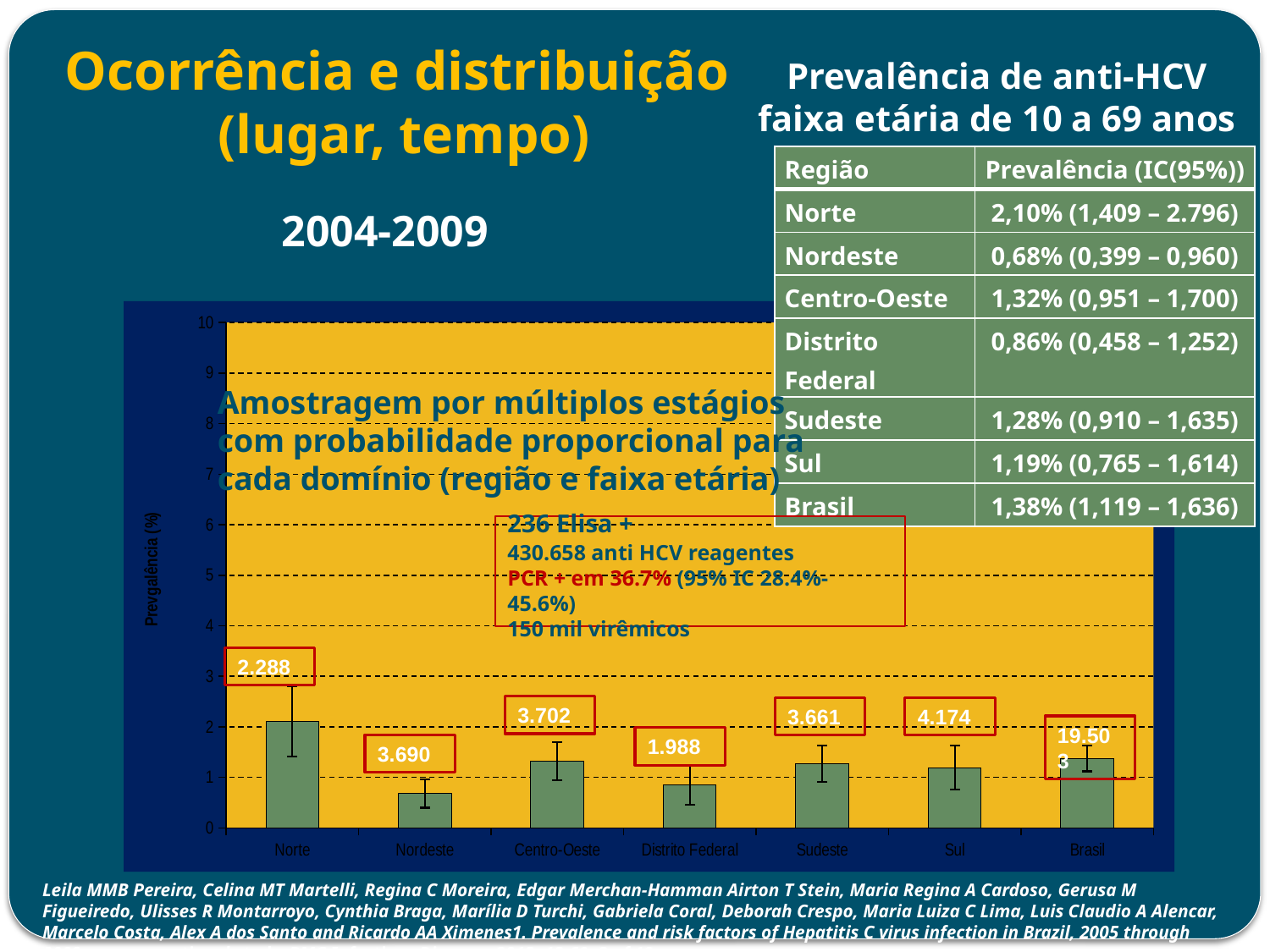
What is the label of the vertical axis of the chart? Prevalência (%) What kind of chart is shown on the slide? bar chart Is the bar for Nordeste greater or less than 1 on the Prevalência (%) axis? less How many regions (categories) are shown on the x axis of the chart? 7 Is the bar for Distrito Federal greater or less than 1 on the Prevalência (%) axis? less Which region has the lowest bar in the chart? Nordeste What number is printed in the red box above the Norte bar? 2.288 Is the bar for Centro-Oeste greater or less than 1 on the Prevalência (%) axis? greater Which bar is taller, Norte or Nordeste? Norte Which bar is taller, Centro-Oeste or Distrito Federal? Centro-Oeste Which region has the highest bar in the chart? Norte